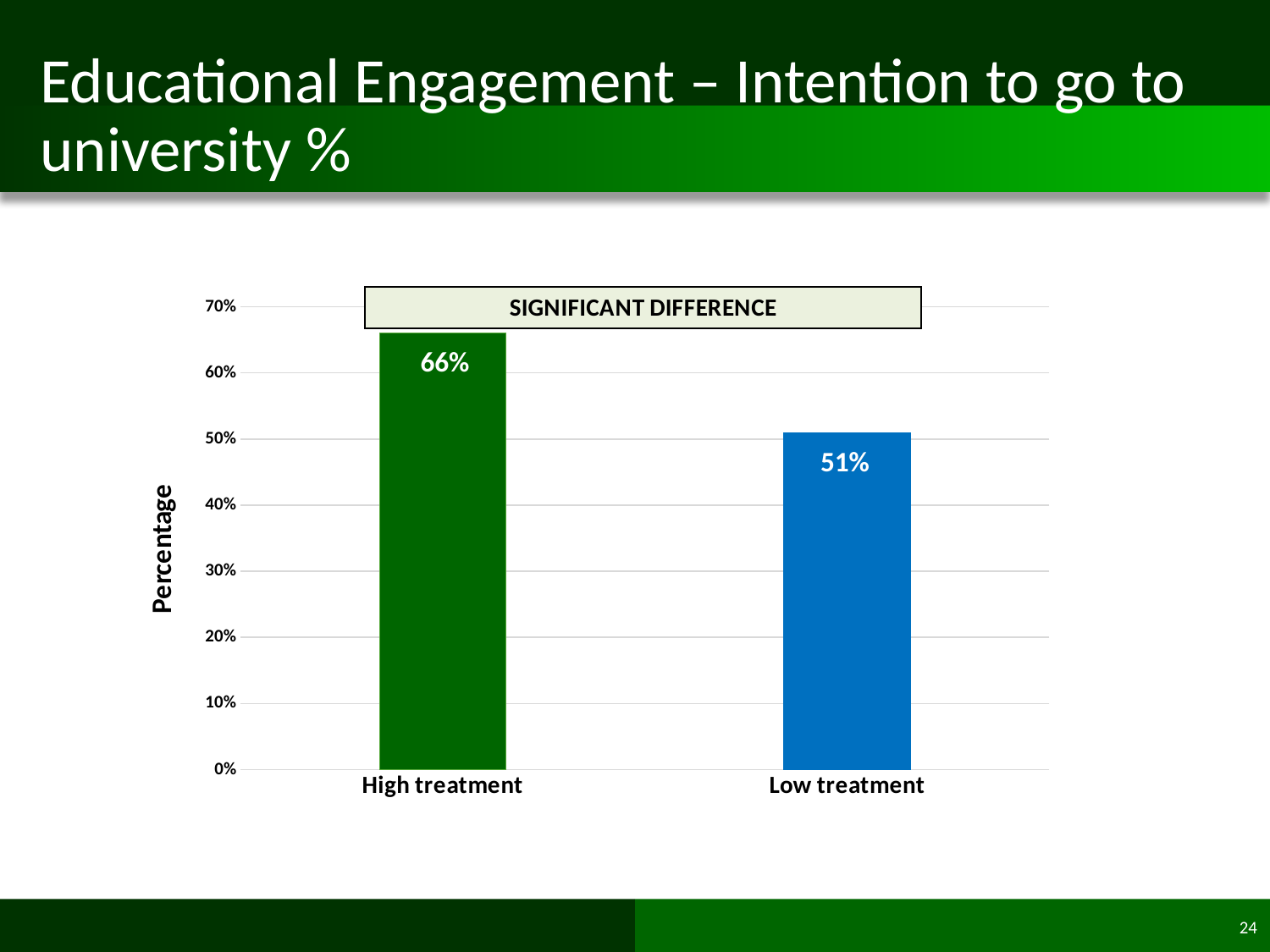
Which is larger, the value for High treatment or for Low treatment? High treatment Is the value for Low treatment greater or less than 60%? less Which category has the highest value? High treatment What is the value for Low treatment? 51% What is the value for High treatment? 66% Which category has the lowest value? Low treatment How many categories are shown on the x axis? 2 What is the label on the vertical axis? Percentage What kind of chart is shown on the slide? bar chart Is the value for High treatment greater or less than 60%? greater What is the difference between the High treatment and Low treatment values? 15% What text appears in the box above the bars? SIGNIFICANT DIFFERENCE